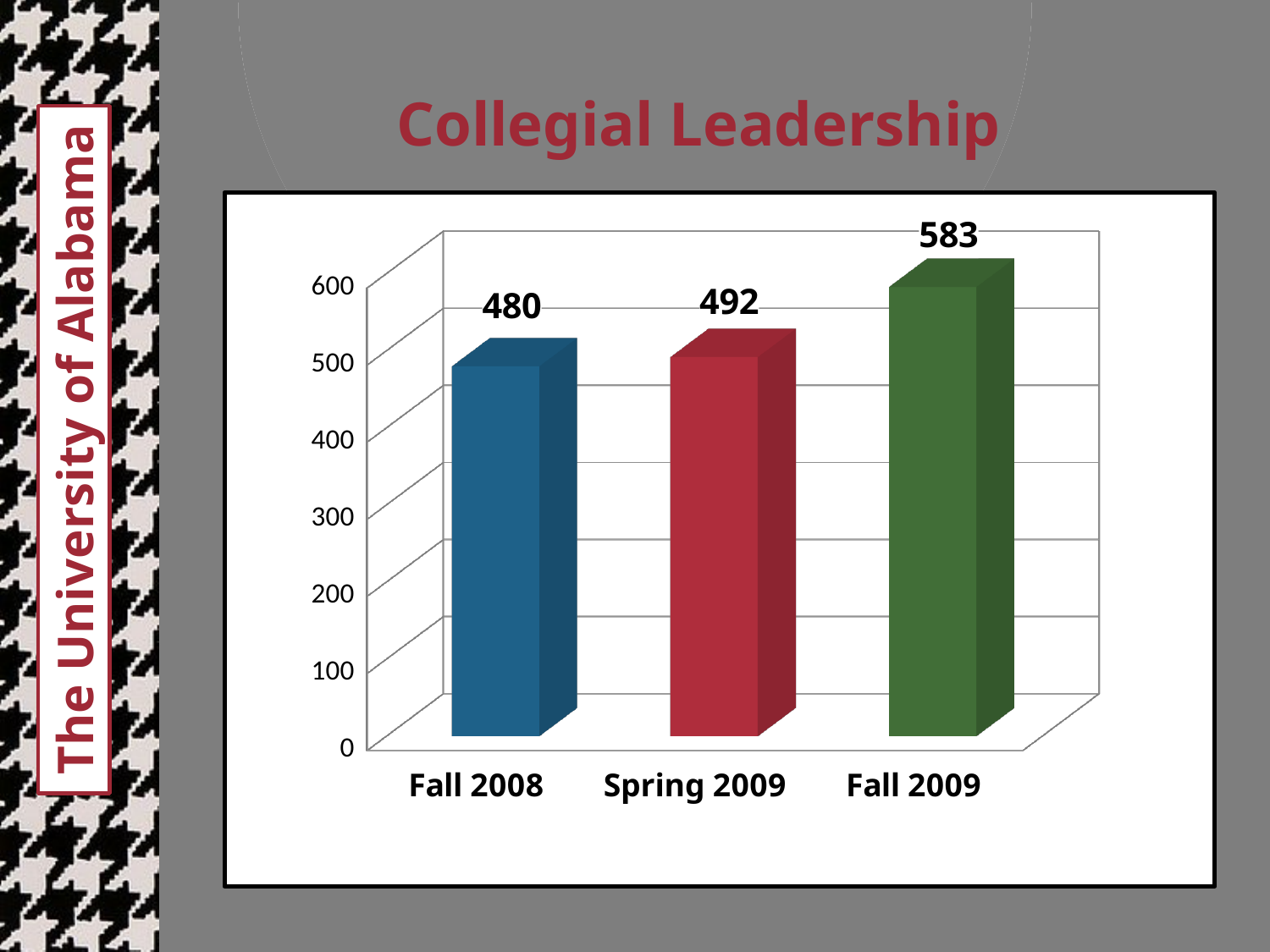
What kind of chart is shown on the slide? bar chart Is the value for Fall 2009 greater or less than 500? greater What is the difference between the values for Fall 2009 and Fall 2008? 103 Which category has the lowest value? Fall 2008 What is the value for Fall 2009? 583 Which category has the highest value? Fall 2009 Do the values rise or fall from Fall 2008 to Fall 2009? rise What is the difference between the values for Spring 2009 and Fall 2008? 12 What is the value for Spring 2009? 492 What is the value for Fall 2008? 480 How many categories are shown on the x axis? 3 Which is larger, the value for Fall 2009 or the value for Spring 2009? Fall 2009